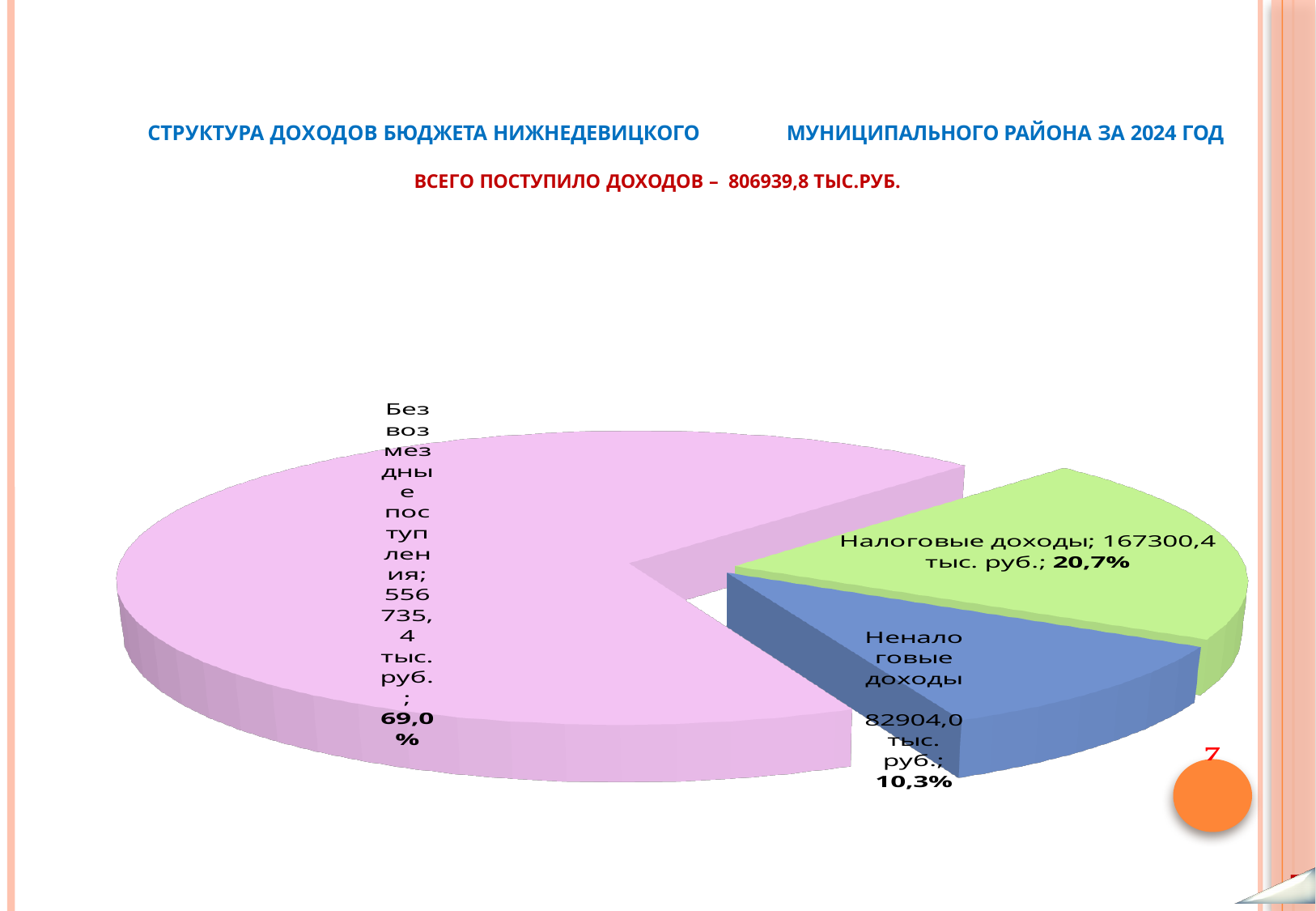
What percentage share is shown for Неналоговые доходы? 10,3% What is the value shown for Неналоговые доходы? 82904,0 тыс. руб. What percentage share is shown for Безвозмездные поступления? 69,0% What type of chart is shown on the slide? pie chart What is the value shown for Налоговые доходы? 167300,4 тыс. руб. How many slices does the pie chart have? 3 What percentage share is shown for Налоговые доходы? 20,7% Which slice of the pie chart is the smallest? Неналоговые доходы What total income amount is stated in the subtitle above the chart? 806939,8 тыс.руб. What is the value shown for Безвозмездные поступления? 556735,4 тыс. руб. Which slice of the pie chart is the largest? Безвозмездные поступления Which is larger, Налоговые доходы or Неналоговые доходы? Налоговые доходы